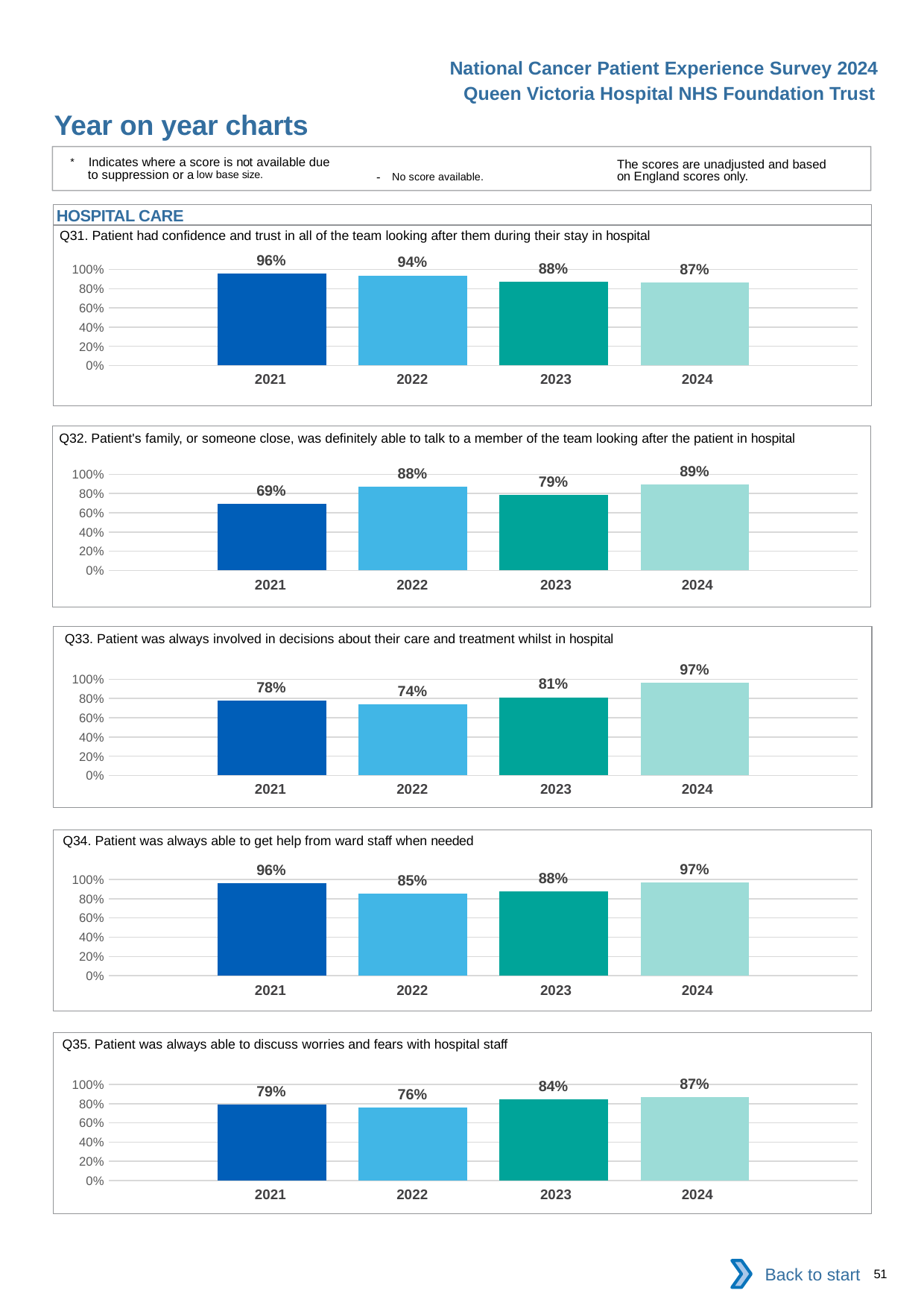
In the Q35 chart (able to discuss worries and fears), what is the value for 2022? 76% In the Q33 chart (involved in decisions about care and treatment), what is the difference between the 2021 and 2022 values? 4 percentage points In the Q33 chart (involved in decisions about care and treatment), what is the value for 2024? 97% In the Q32 chart (family able to talk to a member of the team), which is larger: the 2022 value or the 2023 value? 2022 What type of chart is used for Q34 (able to get help from ward staff)? bar chart How many years are shown in the Q33 chart (involved in decisions about care and treatment)? 4 In the Q31 chart (confidence and trust in the team), do the values rise or fall from 2021 to 2024? fall In the Q32 chart (family able to talk to a member of the team), which year has the lowest value? 2021 In the Q31 chart (confidence and trust in the team), what is the value for 2021? 96% How many charts are shown on the slide under the HOSPITAL CARE heading? 5 In the Q35 chart (able to discuss worries and fears), which year has the highest value? 2024 In the Q34 chart (able to get help from ward staff), what is the difference between the 2024 and 2022 values? 12 percentage points